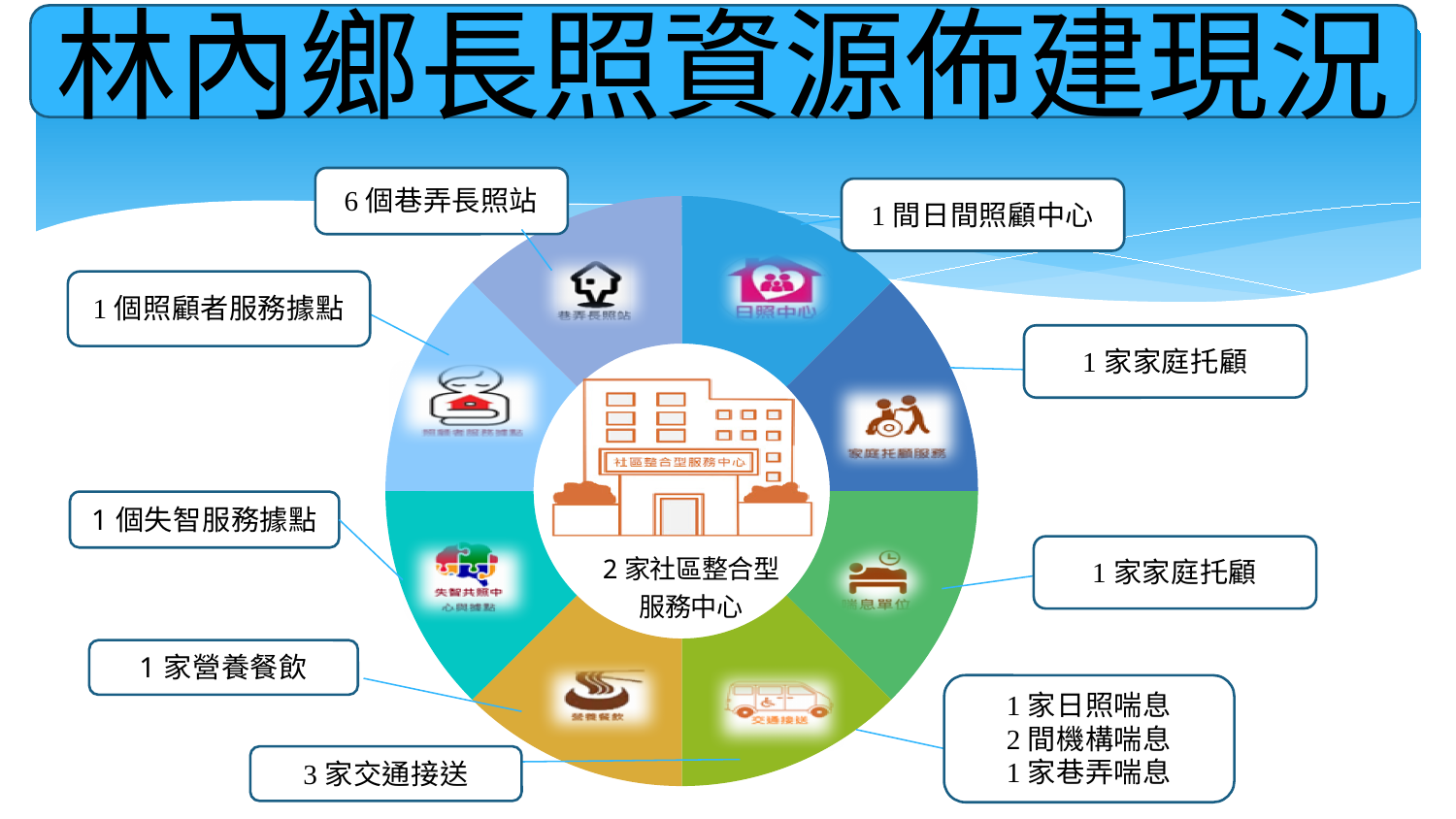
What is the title of the slide? 林內鄉長照資源佈建現況 How many 照顧者服務據點 are shown in the callout? 1 個 How many segments make up the ring diagram? 8 How many 營養餐飲 providers are indicated? 1 家 Which resource type has the largest number in the callouts, 巷弄長照站 or 交通接送? 巷弄長照站 How many 失智服務據點 does the callout list? 1 個 What kind of diagram is used on the slide? Ring (donut) diagram In the 喘息 callout, how many 機構喘息 are listed? 2 間 According to the callout on the ring diagram, how many 巷弄長照站 are there? 6 個 How many 日間照顧中心 does the diagram indicate? 1 間 How many 交通接送 providers are indicated? 3 家 How many 社區整合型服務中心 are shown in the centre of the ring? 2 家